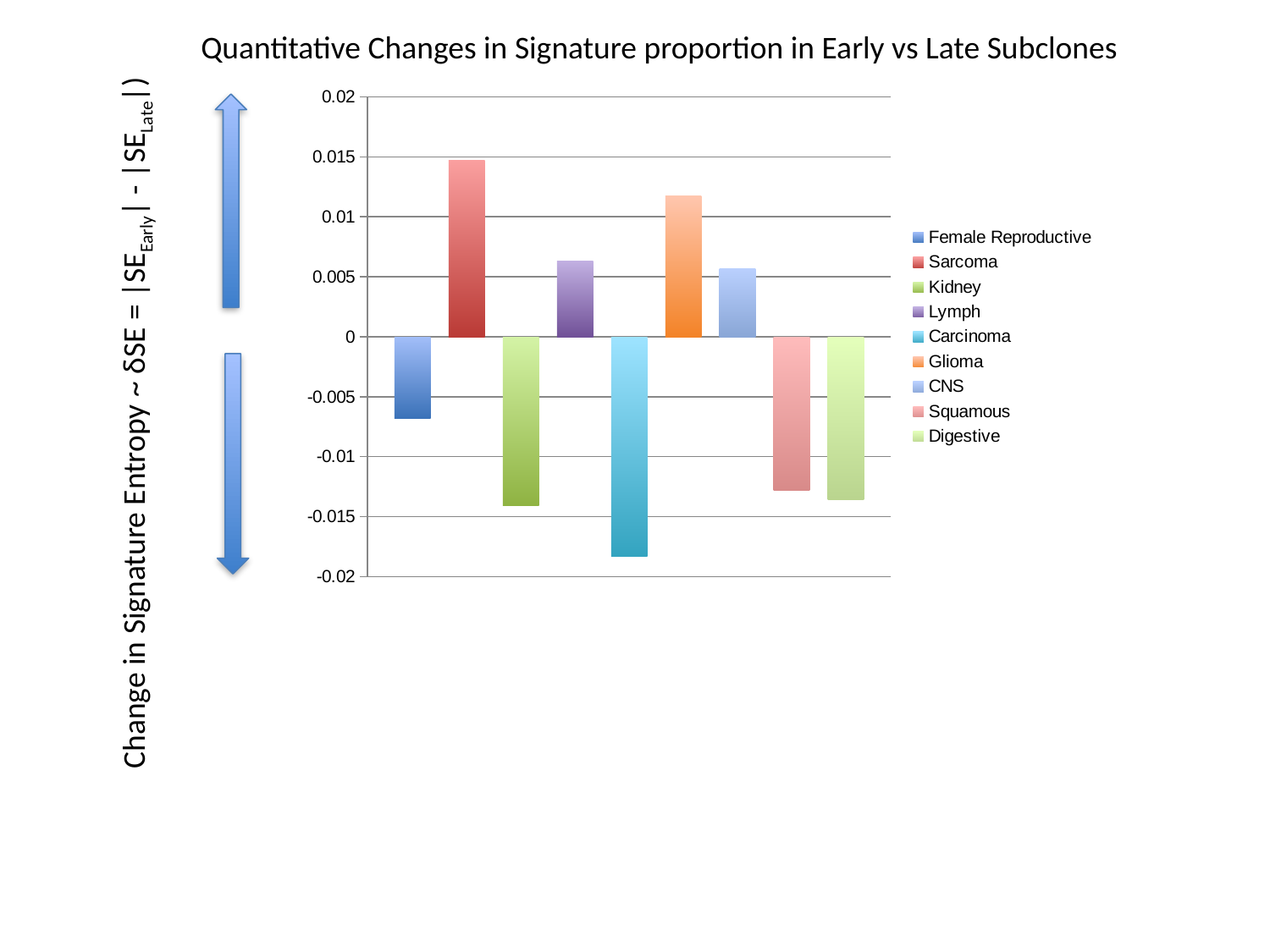
Is the value for Kidney greater or less than -0.01? less Which category has the highest value? Sarcoma Which is larger, the value for Sarcoma or the value for Glioma? Sarcoma Which is larger, the value for Female Reproductive or the value for Squamous? Female Reproductive What kind of chart is shown on the slide? bar chart What is the title of the chart? Quantitative Changes in Signature proportion in Early vs Late Subclones Is the value for Carcinoma greater or less than -0.015? less Which category has the lowest value? Carcinoma Is the value for Sarcoma greater or less than 0.01? greater How many series does the legend list? 9 How many bars are plotted in the chart? 9